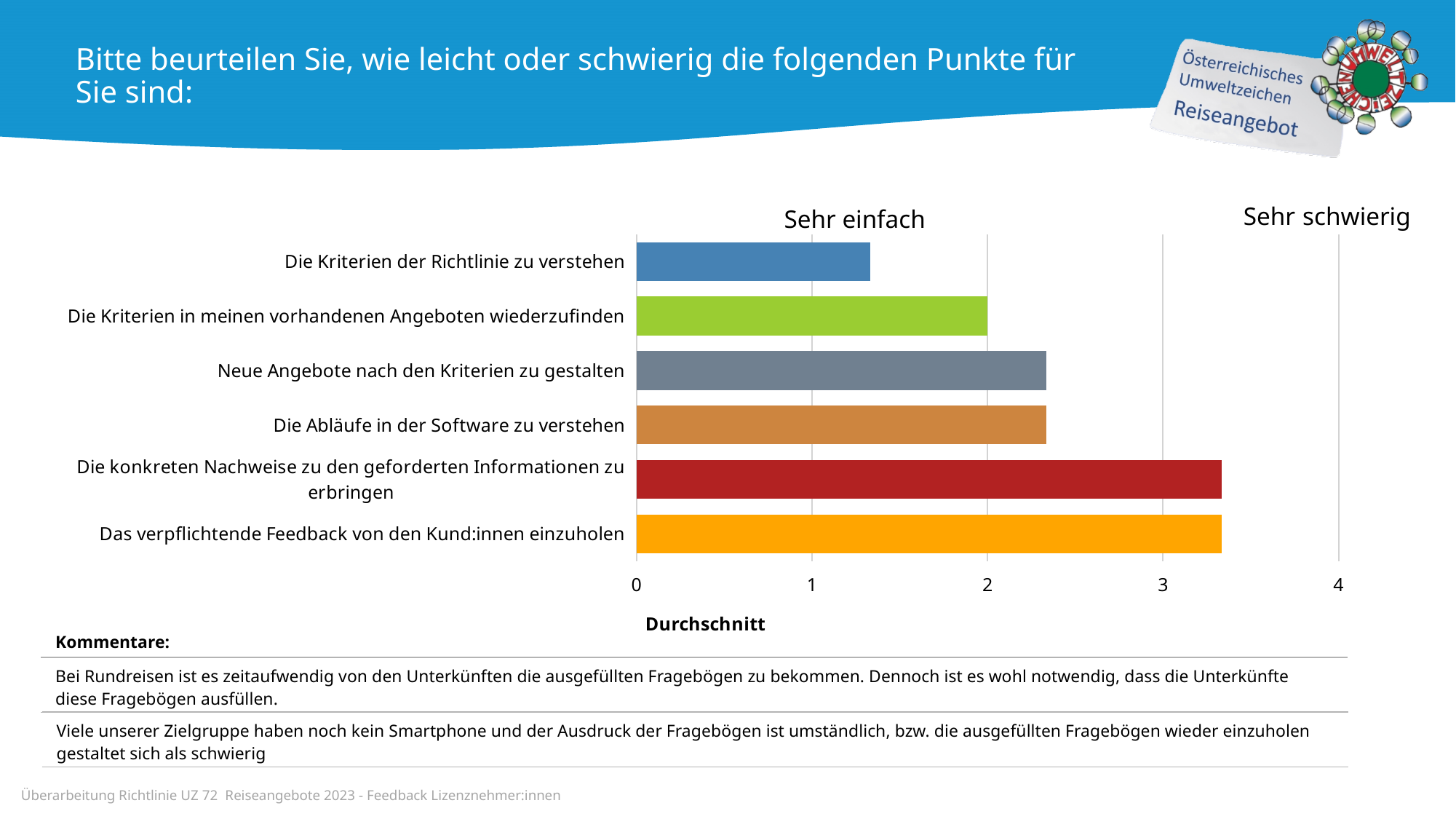
What is the title of the horizontal axis of the chart? Durchschnitt How many categories (items) are plotted in the chart? 6 What kind of chart is shown on the slide? bar chart Is the value for "Die Kriterien der Richtlinie zu verstehen" greater or less than 1? greater Is the value for "Die konkreten Nachweise zu den geforderten Informationen zu erbringen" greater or less than 3? greater Is the value for "Die Kriterien der Richtlinie zu verstehen" greater or less than 2? less What colour is the bar for "Das verpflichtende Feedback von den Kund:innen einzuholen"? orange Which item has the lowest average value in the chart? Die Kriterien der Richtlinie zu verstehen What is the value for "Die Kriterien in meinen vorhandenen Angeboten wiederzufinden"? 2 Which has the larger value: "Die Kriterien der Richtlinie zu verstehen" or "Das verpflichtende Feedback von den Kund:innen einzuholen"? Das verpflichtende Feedback von den Kund:innen einzuholen